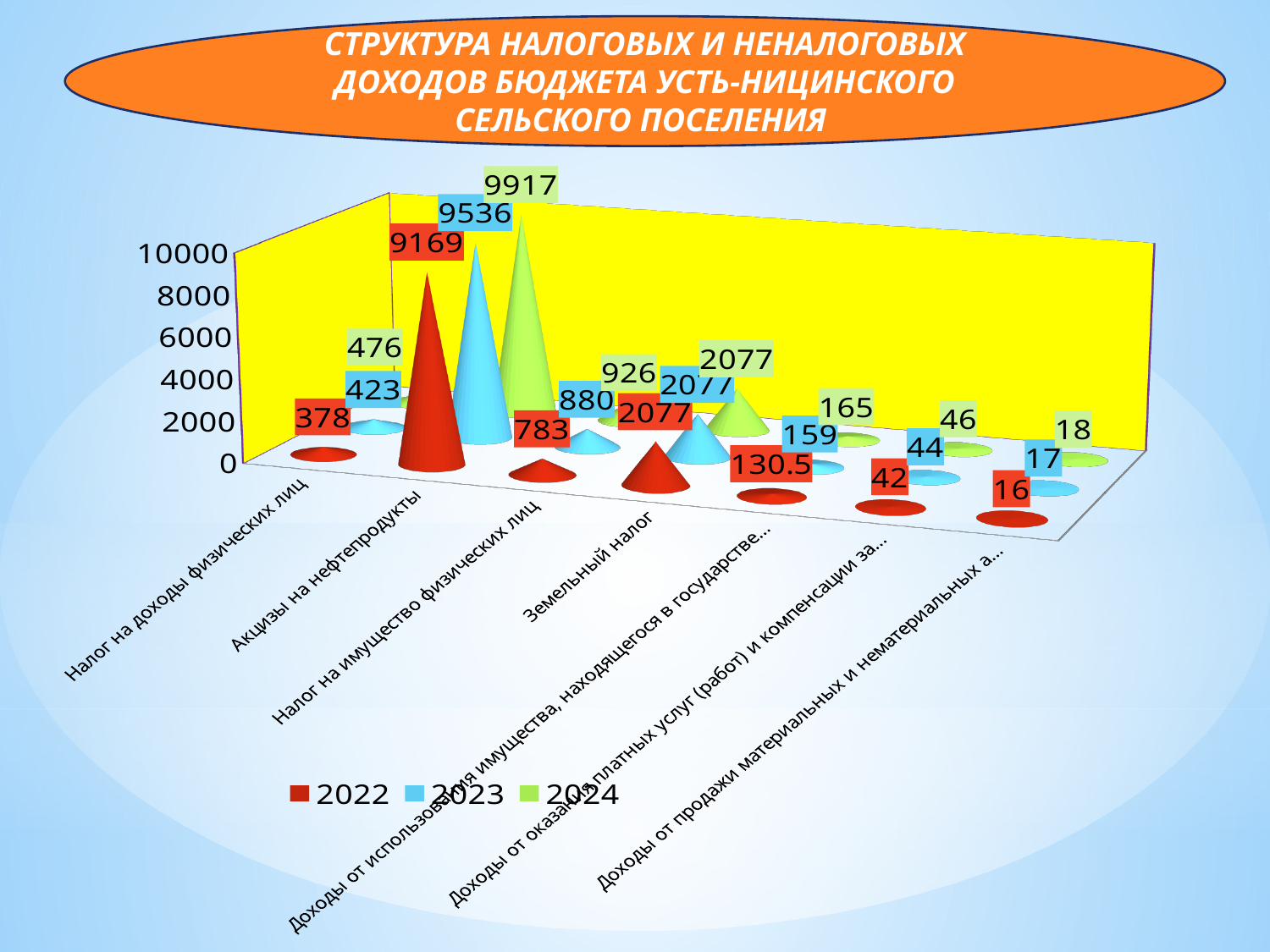
How many categories are shown on the x axis? 7 Do the values for Налог на доходы физических лиц rise or fall from 2022 to 2024? rise Which category has the highest value in 2023? Акцизы на нефтепродукты Which category has the lowest value in 2024? Доходы от продажи материальных и нематериальных а... What is the value for Акцизы на нефтепродукты in 2024? 9917 What kind of chart is shown on the slide? 3D bar chart (cone-shaped bars) How many series does the legend list? 3 What is the value for Налог на доходы физических лиц in 2022? 378 What is the value for Земельный налог in 2023? 2077 What is the 2022 value for Доходы от использования имущества, находящегося в государстве...? 130.5 What is the difference between the 2024 and 2022 values for Акцизы на нефтепродукты? 748 Which is larger for Налог на имущество физических лиц: the 2022 value or the 2023 value? 2023